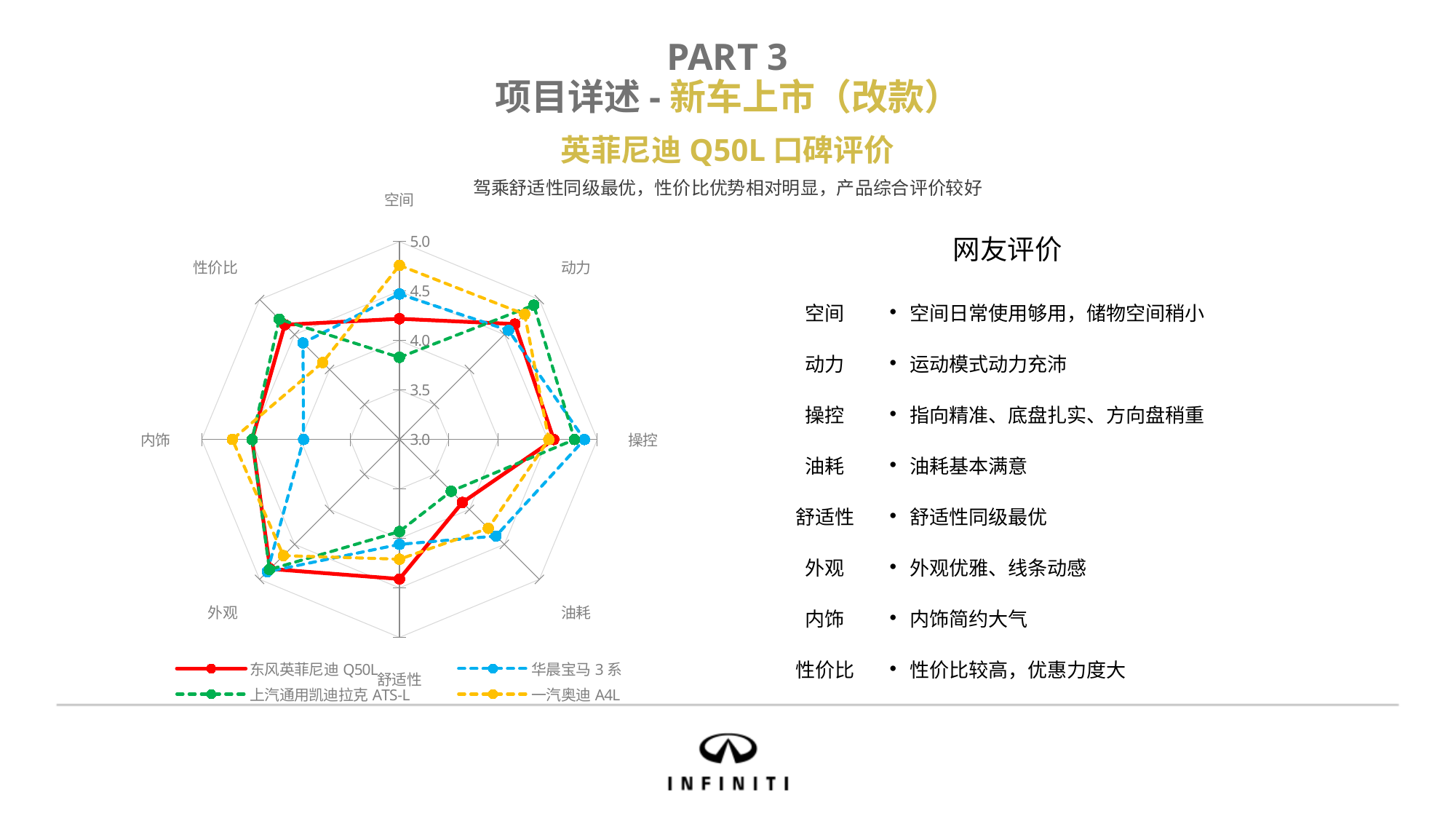
How many evaluation categories (axes) does the radar chart have? 8 Which series has the highest value on the 空间 axis? 一汽奥迪 A4L Is the 操控 value for 华晨宝马 3系 greater or less than 4.5? greater Is the 空间 value for 上汽通用凯迪拉克 ATS-L greater or less than 4.0? less How many series does the legend of the radar chart list? 4 What is the maximum value shown on the radar chart's scale? 5.0 What kind of chart is shown on the slide? Radar chart Is the 舒适性 value for 东风英菲尼迪 Q50L greater or less than 4.0? greater Which series has the lowest value on the 空间 axis? 上汽通用凯迪拉克 ATS-L On the 舒适性 axis, which is larger: 东风英菲尼迪 Q50L or 上汽通用凯迪拉克 ATS-L? 东风英菲尼迪 Q50L Which colour is used for the 东风英菲尼迪 Q50L series in the radar chart? Red Which series has the highest value on the 舒适性 axis? 东风英菲尼迪 Q50L